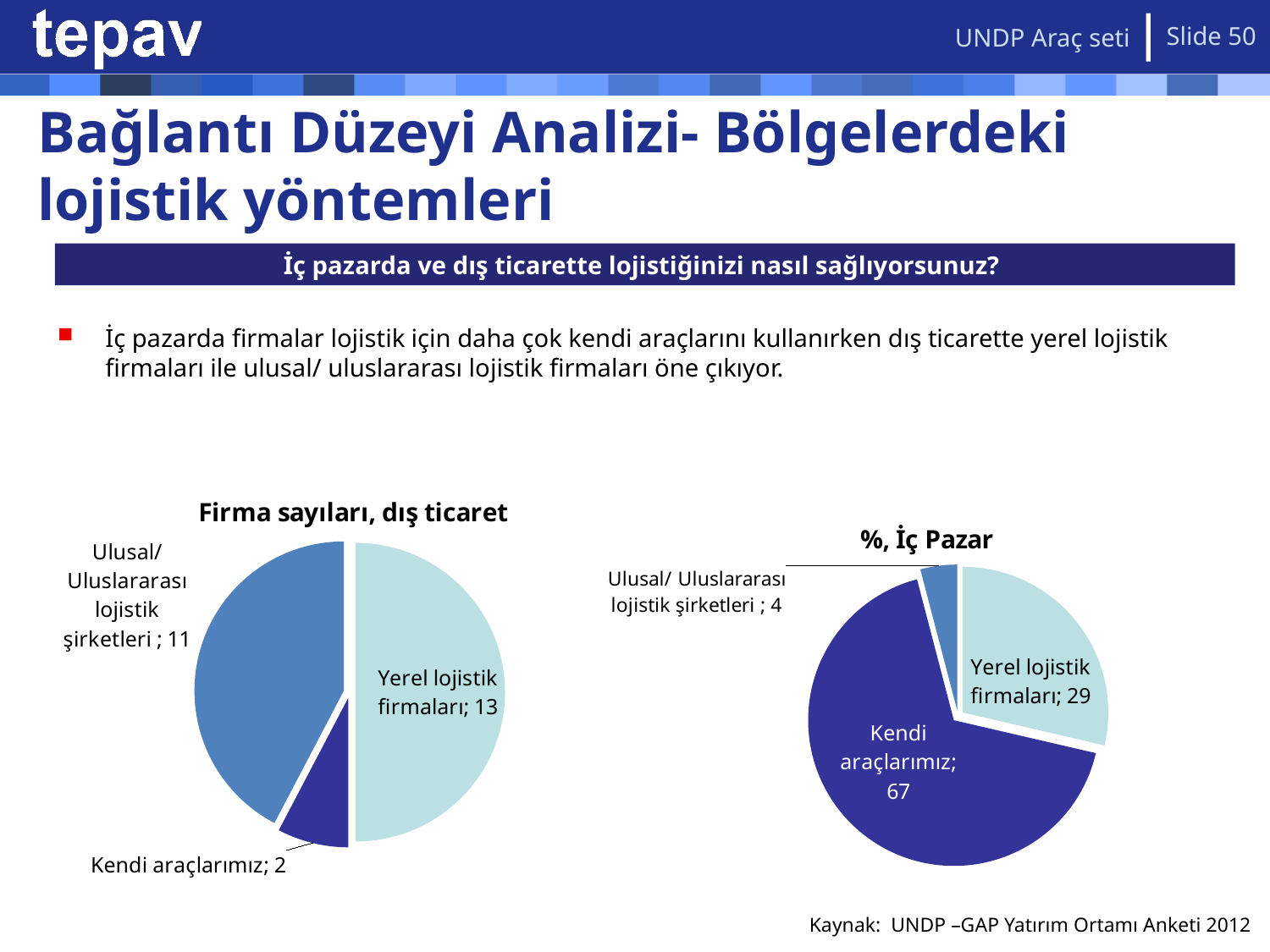
In the chart titled "%, İç Pazar", which category has the smallest value? Ulusal/ Uluslararası lojistik şirketleri In the chart titled "%, İç Pazar", what is the value for Ulusal/ Uluslararası lojistik şirketleri? 4 In the chart titled "Firma sayıları, dış ticaret", which category has the largest value? Yerel lojistik firmaları What type of chart is the chart titled "%, İç Pazar"? Pie chart How many slices does the chart titled "Firma sayıları, dış ticaret" have? 3 In the chart titled "%, İç Pazar", which is larger: Kendi araçlarımız or Yerel lojistik firmaları? Kendi araçlarımız In the chart titled "%, İç Pazar", what is the value for Kendi araçlarımız? 67 In the chart titled "%, İç Pazar", what is the difference between Kendi araçlarımız and Yerel lojistik firmaları? 38 In the chart titled "Firma sayıları, dış ticaret", what is the value for Kendi araçlarımız? 2 In the chart titled "Firma sayıları, dış ticaret", what share of the total does Yerel lojistik firmaları represent? 50% In the chart titled "Firma sayıları, dış ticaret", what is the difference between Yerel lojistik firmaları and Ulusal/ Uluslararası lojistik şirketleri? 2 In the chart titled "Firma sayıları, dış ticaret", what is the value for Yerel lojistik firmaları? 13